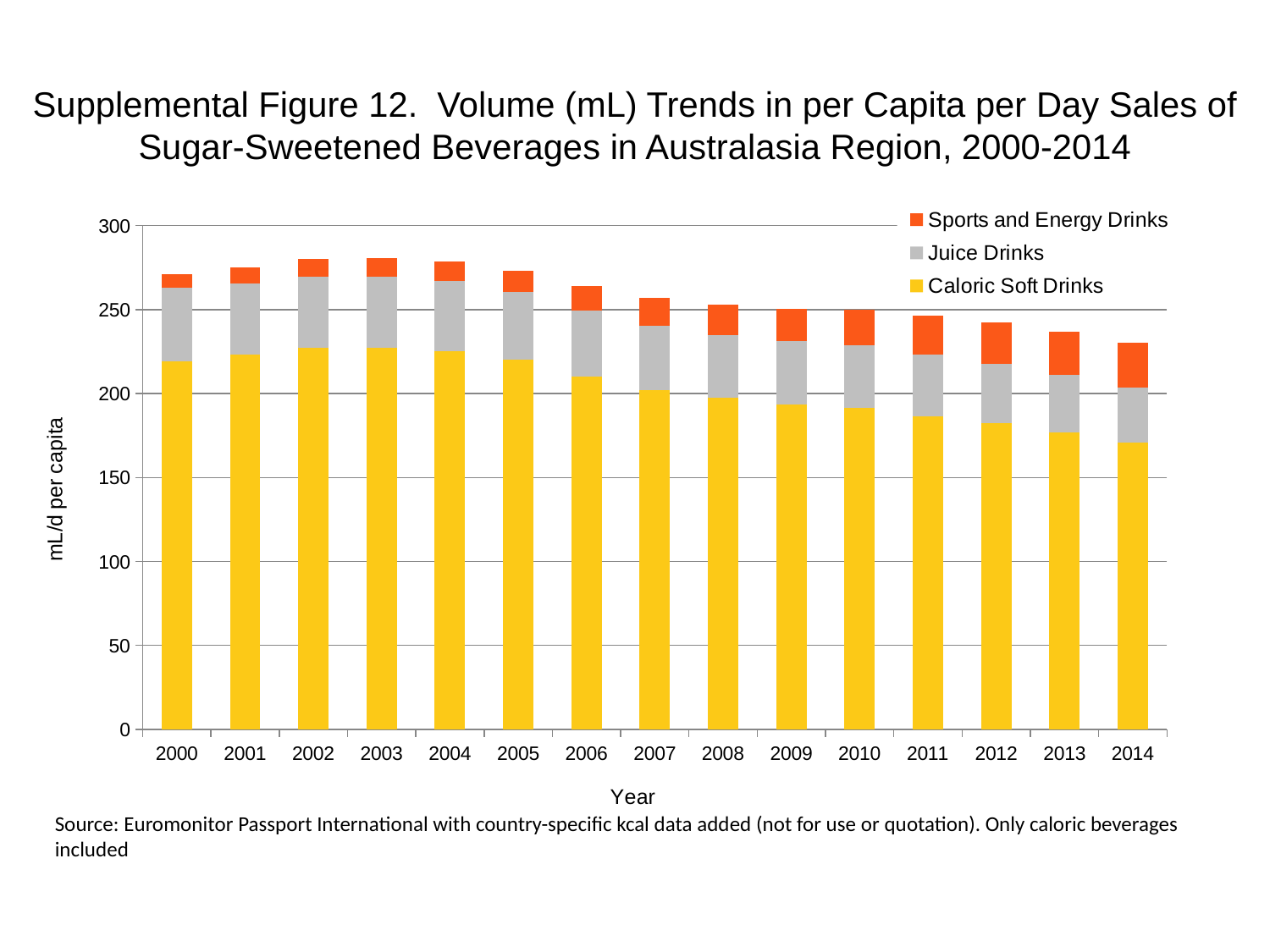
How many series does the legend list? 3 How many years are shown along the x axis? 15 Is the value for Caloric Soft Drinks in 2000 greater or less than 200? greater Which year has the lowest value for Caloric Soft Drinks? 2014 Is the total stacked bar for 2014 greater or less than 250? less Which year has the lowest total stacked bar? 2014 What kind of chart is shown on the slide? Stacked bar chart Is the total stacked bar for 2003 greater or less than 250? greater Does the Caloric Soft Drinks value rise or fall from 2003 to 2014? fall Which is larger, the total stacked bar for 2000 or for 2014? 2000 What is the label on the y axis? mL/d per capita